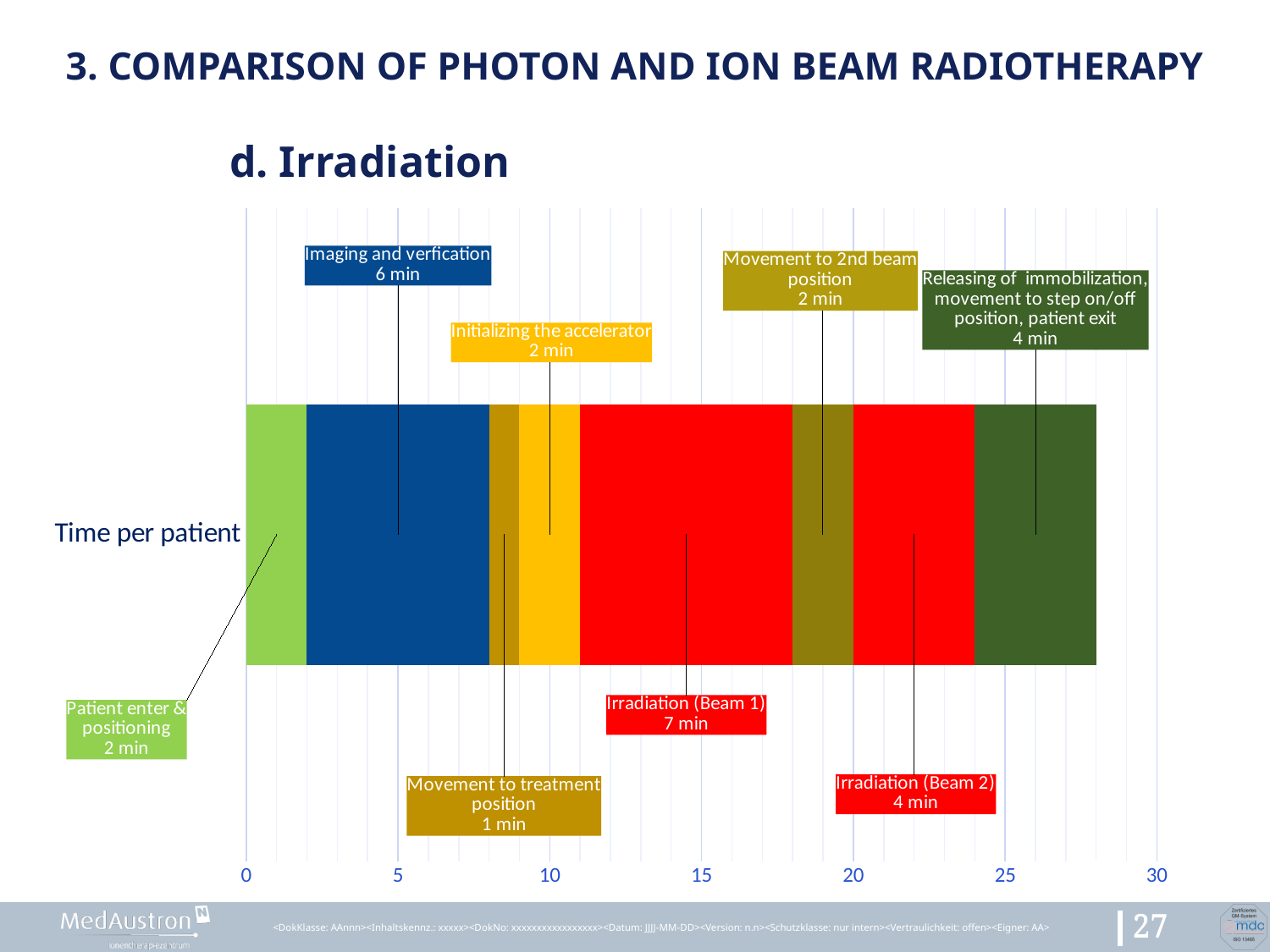
How many segments make up the 'Time per patient' bar? 8 What kind of chart is shown on the slide? Stacked bar chart How many minutes does the 'Imaging and verification' segment take? 6 min Which takes longer, 'Imaging and verification' or 'Initializing the accelerator'? Imaging and verification How many minutes does 'Irradiation (Beam 2)' take? 4 min Which segment of the bar takes the shortest time? Movement to treatment position How many minutes does 'Movement to treatment position' take? 1 min What is the total time per patient shown by the full stacked bar? 28 min What is the maximum value shown on the horizontal axis? 30 How many minutes does 'Irradiation (Beam 1)' take? 7 min Which segment of the bar takes the longest time? Irradiation (Beam 1) What is the difference in minutes between 'Irradiation (Beam 1)' and 'Irradiation (Beam 2)'? 3 min